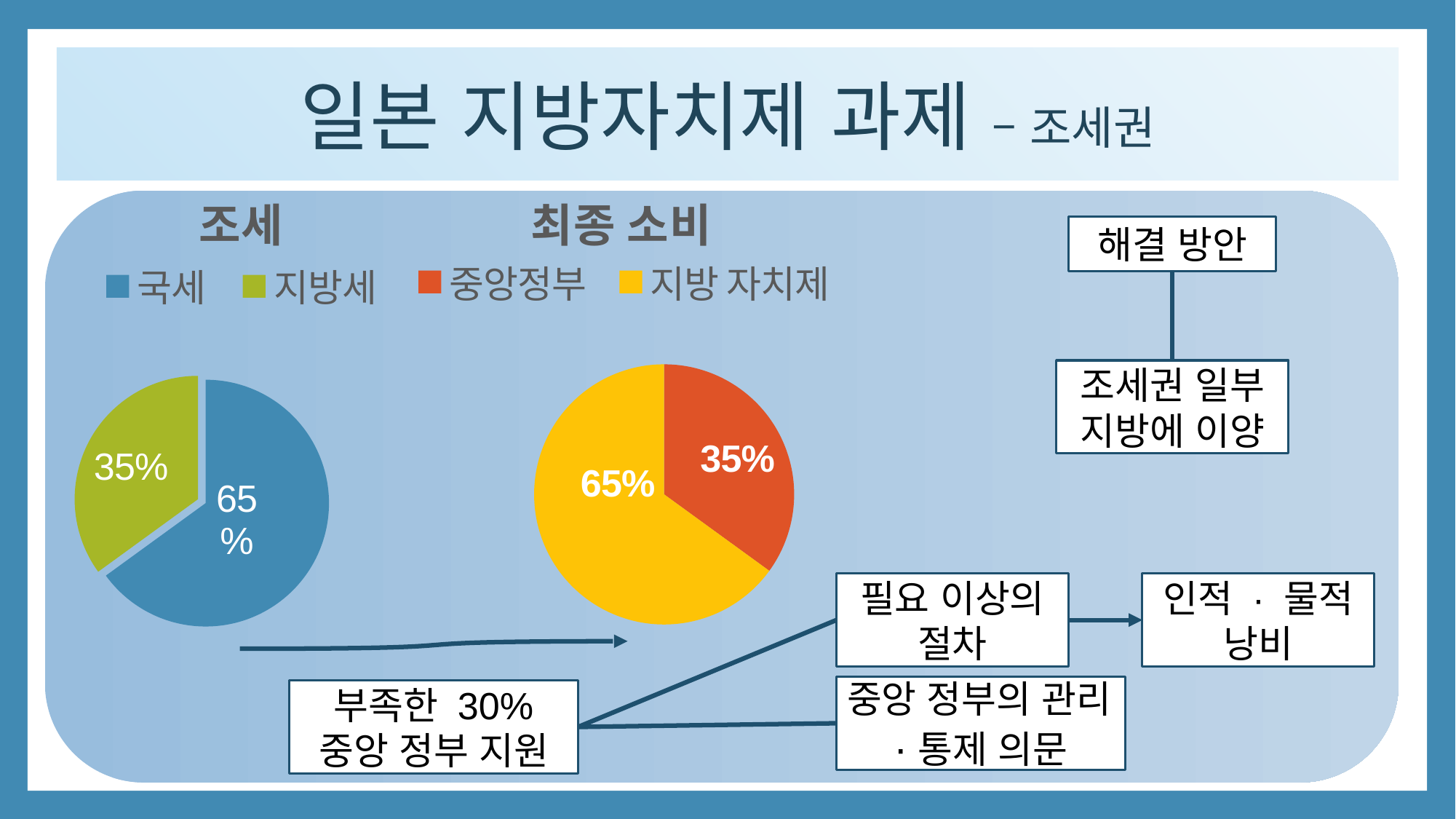
What kind of chart is the 조세 chart? Pie chart In the 최종 소비 chart, what share does 중앙정부 have? 35% In the 최종 소비 chart, which is larger, 중앙정부 or 지방 자치제? 지방 자치제 In the 조세 chart, what share does 국세 have? 65% How many entries does the legend of the 조세 chart list? 2 In the 조세 chart, which category has the largest slice? 국세 In the 최종 소비 chart, what colour is the 지방 자치제 slice? Yellow In the 최종 소비 chart, what share does 지방 자치제 have? 65% How many slices does the 최종 소비 chart have? 2 In the 최종 소비 chart, which category has the smallest slice? 중앙정부 In the 조세 chart, what is the difference between the 국세 and 지방세 shares? 30% In the 조세 chart, what share does 지방세 have? 35%